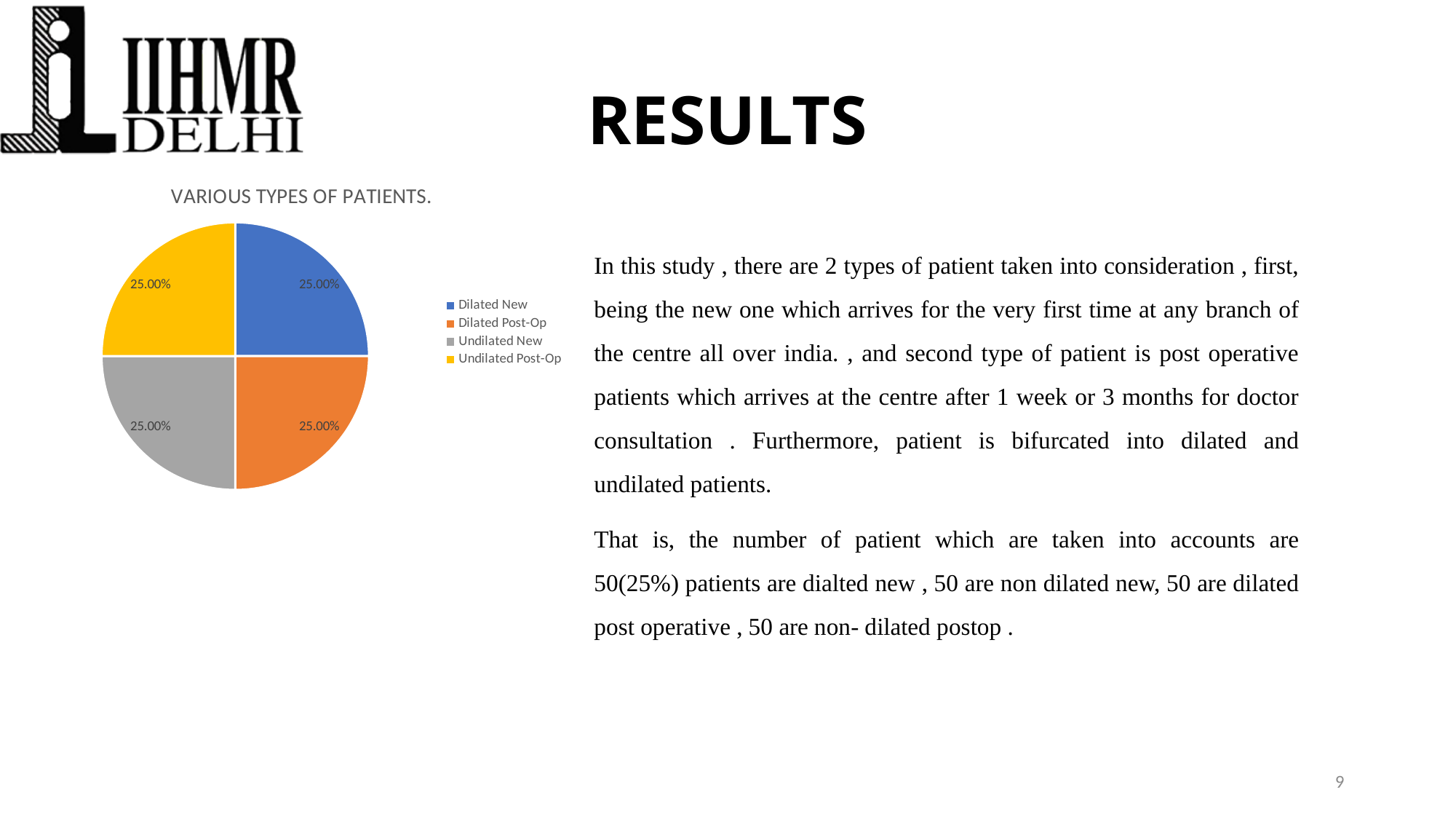
What percentage is shown for Undilated Post-Op? 25.00% What share of the pie does the Undilated Post-Op slice take? 25.00% What percentage is shown for Dilated New? 25.00% How many slices does the pie chart have? 4 What kind of chart is shown on the slide? pie chart What percentage is shown for Undilated New? 25.00% Which colour represents Undilated New in the pie chart? gray How many entries does the chart legend list? 4 What is the difference between the Dilated New and Undilated New percentages? 0.00% What is the title of the chart? VARIOUS TYPES OF PATIENTS. What percentage is shown for Dilated Post-Op? 25.00%